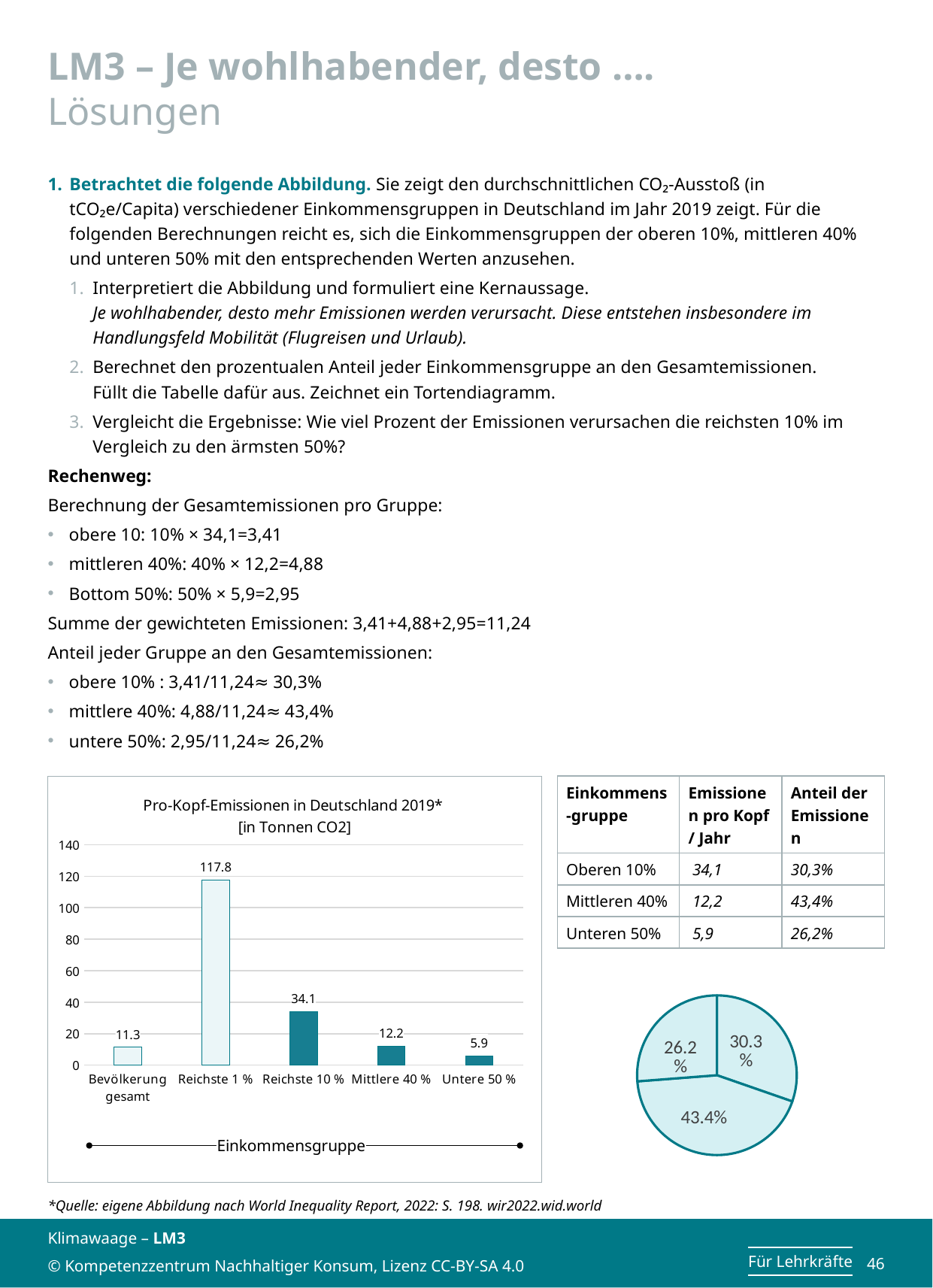
How many categories are shown in the bar chart 'Pro-Kopf-Emissionen in Deutschland 2019'? 5 In the bar chart 'Pro-Kopf-Emissionen in Deutschland 2019', is the value for Reichste 1 % greater or less than 100? greater What is the unit given in the title of the bar chart 'Pro-Kopf-Emissionen in Deutschland 2019'? Tonnen CO2 In the bar chart 'Pro-Kopf-Emissionen in Deutschland 2019', what is the value for Reichste 1 %? 117.8 In the bar chart 'Pro-Kopf-Emissionen in Deutschland 2019', what is the value for Bevölkerung gesamt? 11.3 In the bar chart 'Pro-Kopf-Emissionen in Deutschland 2019', which category has the highest value? Reichste 1 % In the bar chart 'Pro-Kopf-Emissionen in Deutschland 2019', what is the difference between the values for Reichste 10 % and Mittlere 40 %? 21.9 In the bar chart 'Pro-Kopf-Emissionen in Deutschland 2019', which category has the lowest value? Untere 50 % What kind of chart is 'Pro-Kopf-Emissionen in Deutschland 2019'? bar chart In the pie chart at the bottom right of the slide, what is the largest slice's share? 43.4% In the bar chart 'Pro-Kopf-Emissionen in Deutschland 2019', what is the value for Untere 50 %? 5.9 In the bar chart 'Pro-Kopf-Emissionen in Deutschland 2019', which is larger: the value for Bevölkerung gesamt or the value for Mittlere 40 %? Mittlere 40 %